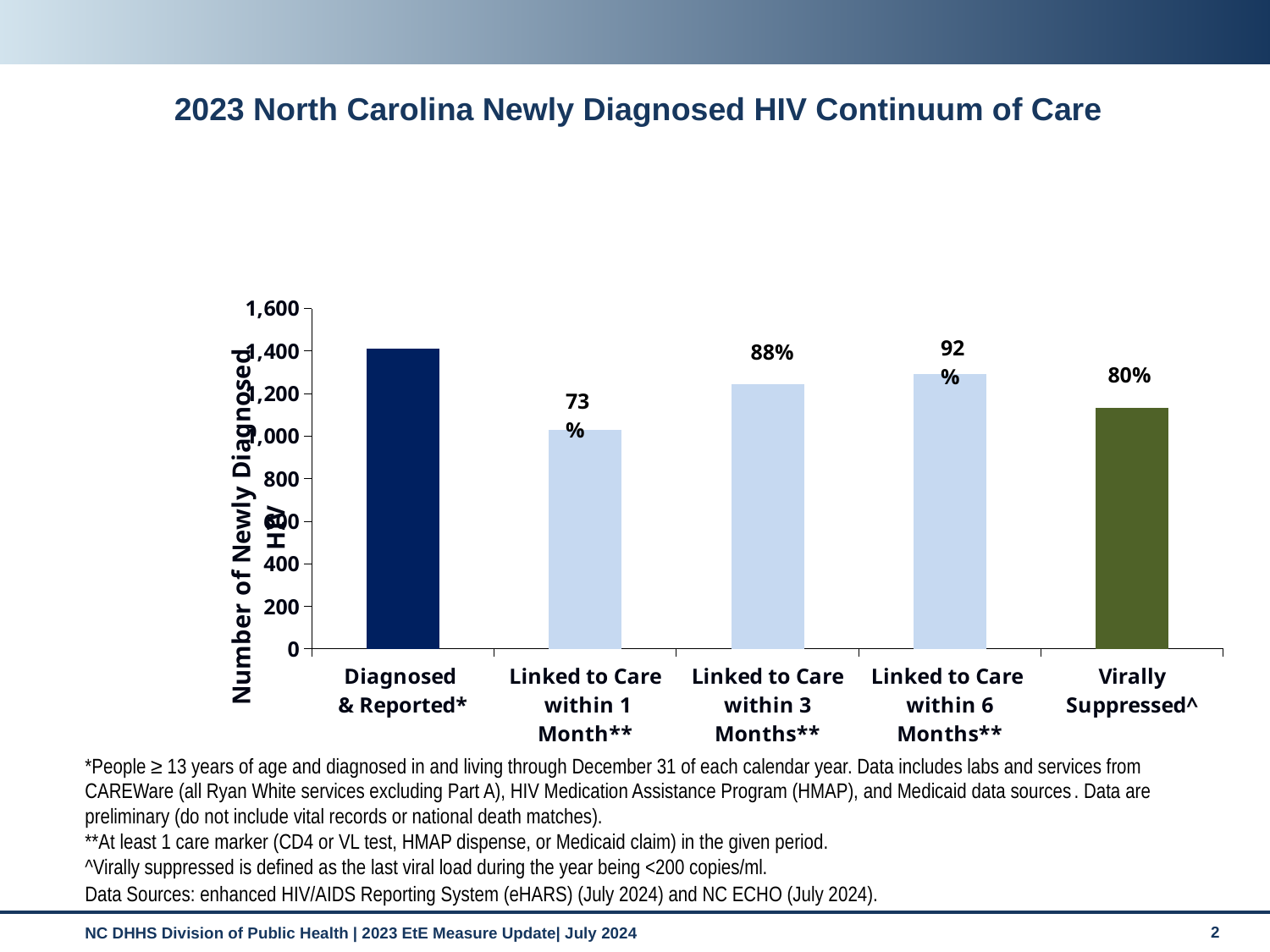
How many categories are shown on the x axis? 5 Is the value for 'Virally Suppressed^' greater or less than 1,000? greater Which bar is taller: 'Linked to Care within 3 Months**' or 'Linked to Care within 6 Months**'? Linked to Care within 6 Months** What is the difference in percentage points between the labels on the 'Linked to Care within 6 Months**' and 'Linked to Care within 1 Month**' bars? 19 percentage points What percentage label is shown on the 'Linked to Care within 3 Months**' bar? 88% What percentage label is shown on the 'Linked to Care within 1 Month**' bar? 73% Which category has the shortest bar? Linked to Care within 1 Month** What type of chart is shown on the slide? Bar chart What percentage label is shown on the 'Linked to Care within 6 Months**' bar? 92% Which category has the tallest bar? Diagnosed & Reported* What percentage label is shown on the 'Virally Suppressed^' bar? 80% Is the value for 'Linked to Care within 6 Months**' greater or less than 1,400? less